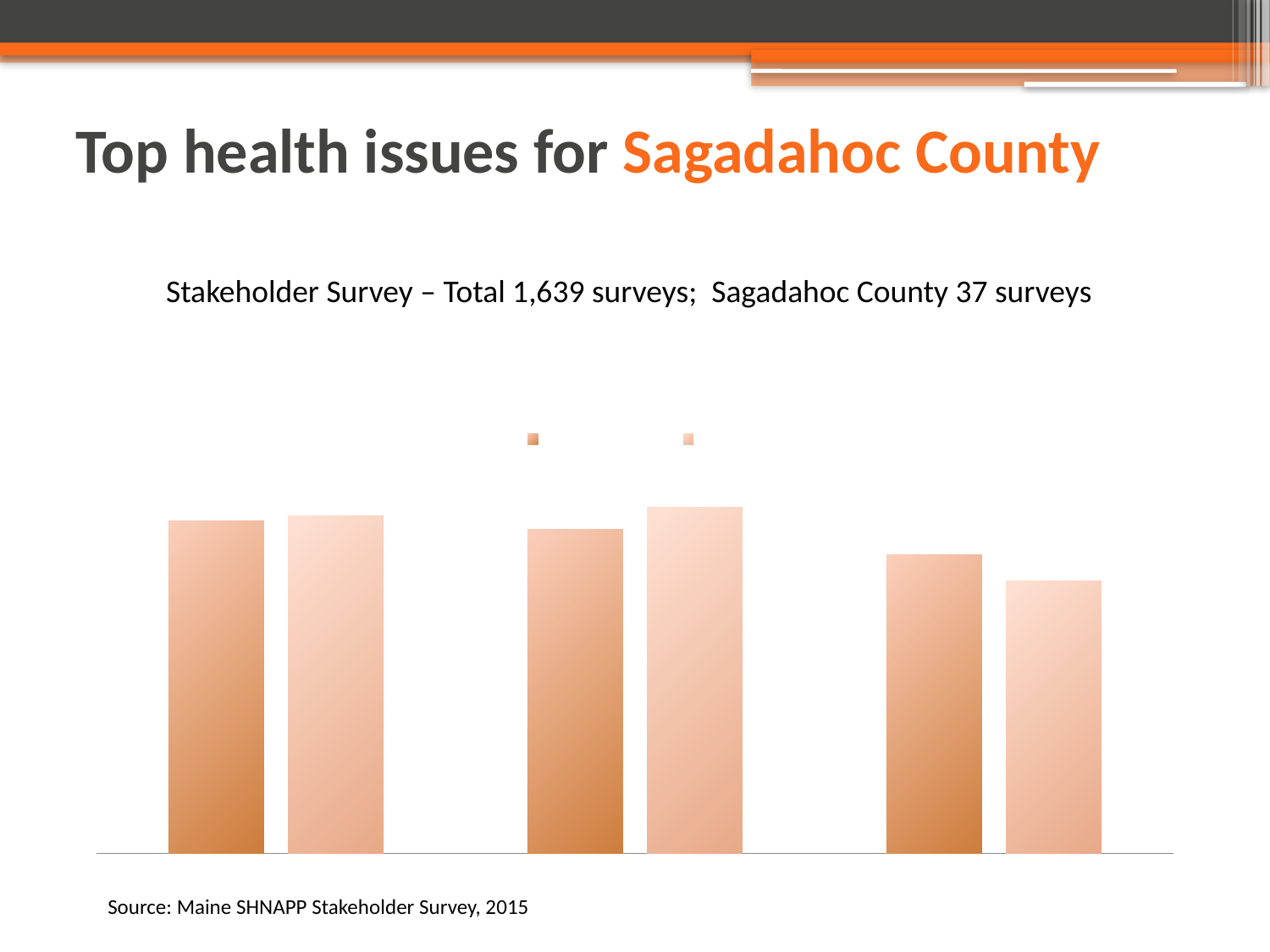
How many series does the chart's legend show? 2 What kind of chart is shown on the slide? bar chart In the middle group of bars, is the darker (left) bar or the lighter (right) bar taller? the lighter (right) bar What source is cited below the chart? Maine SHNAPP Stakeholder Survey, 2015 Are the bars in the chart vertical or horizontal? vertical In the rightmost group of bars, is the darker (left) bar or the lighter (right) bar taller? the darker (left) bar How many bars are plotted in the chart in total? 6 Which group of bars contains the tallest bar in the chart: the left, middle, or right group? the middle group Which group of bars contains the shortest bar in the chart: the left, middle, or right group? the right group How many groups of bars are plotted in the chart? 3